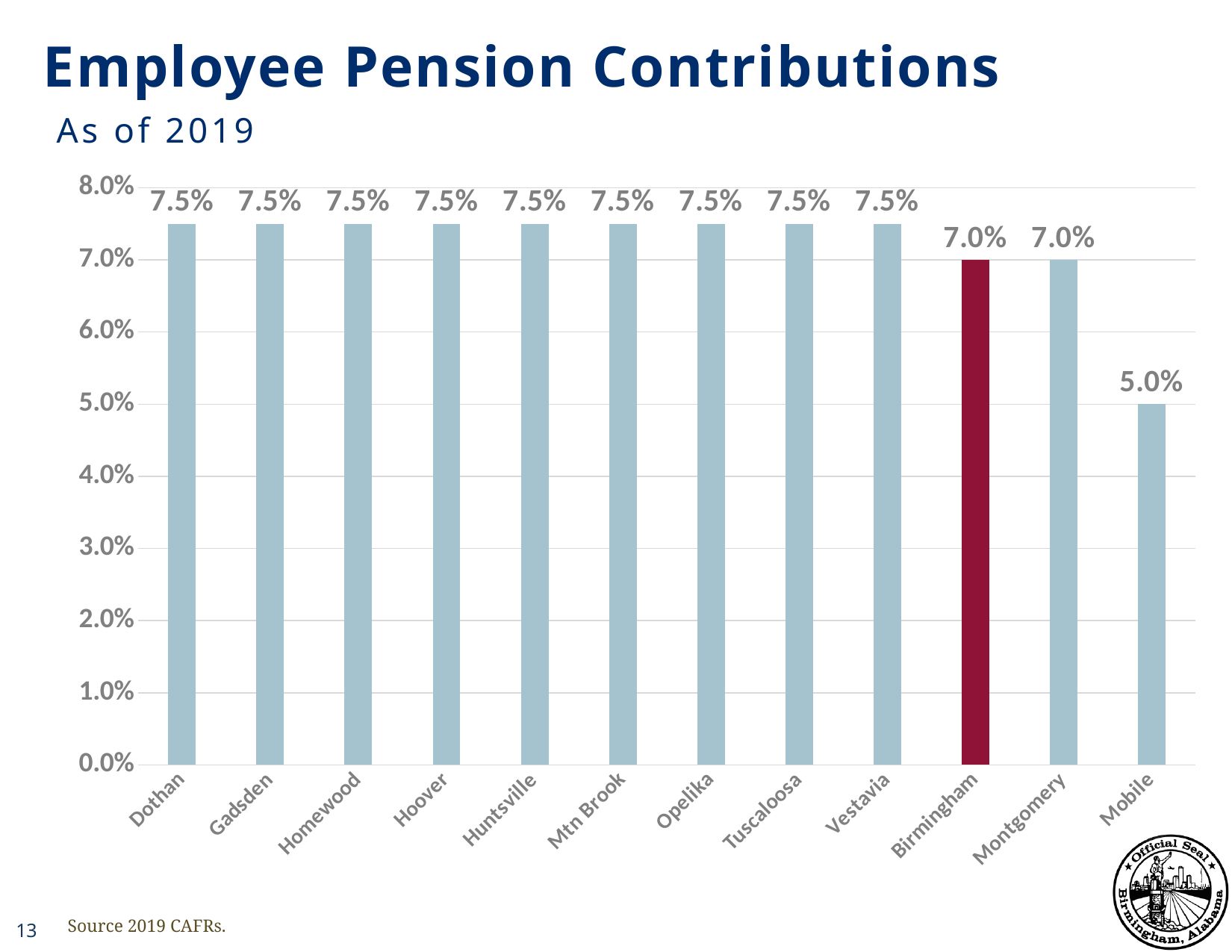
What is the employee pension contribution for Birmingham? 7.0% What is the employee pension contribution for Montgomery? 7.0% Which city has the lowest employee pension contribution? Mobile What is the difference between the employee pension contribution for Dothan and for Mobile? 2.5% What is the employee pension contribution for Huntsville? 7.5% Which is larger, the employee pension contribution for Hoover or for Montgomery? Hoover What kind of chart is shown on the slide? Bar chart Is the value for Mobile greater or less than 6.0%? less How many cities are shown in the chart? 12 What is the difference between the employee pension contribution for Vestavia and for Birmingham? 0.5% What is the employee pension contribution for Mobile? 5.0% Which city's bar is highlighted in a different colour (dark red) from the others? Birmingham